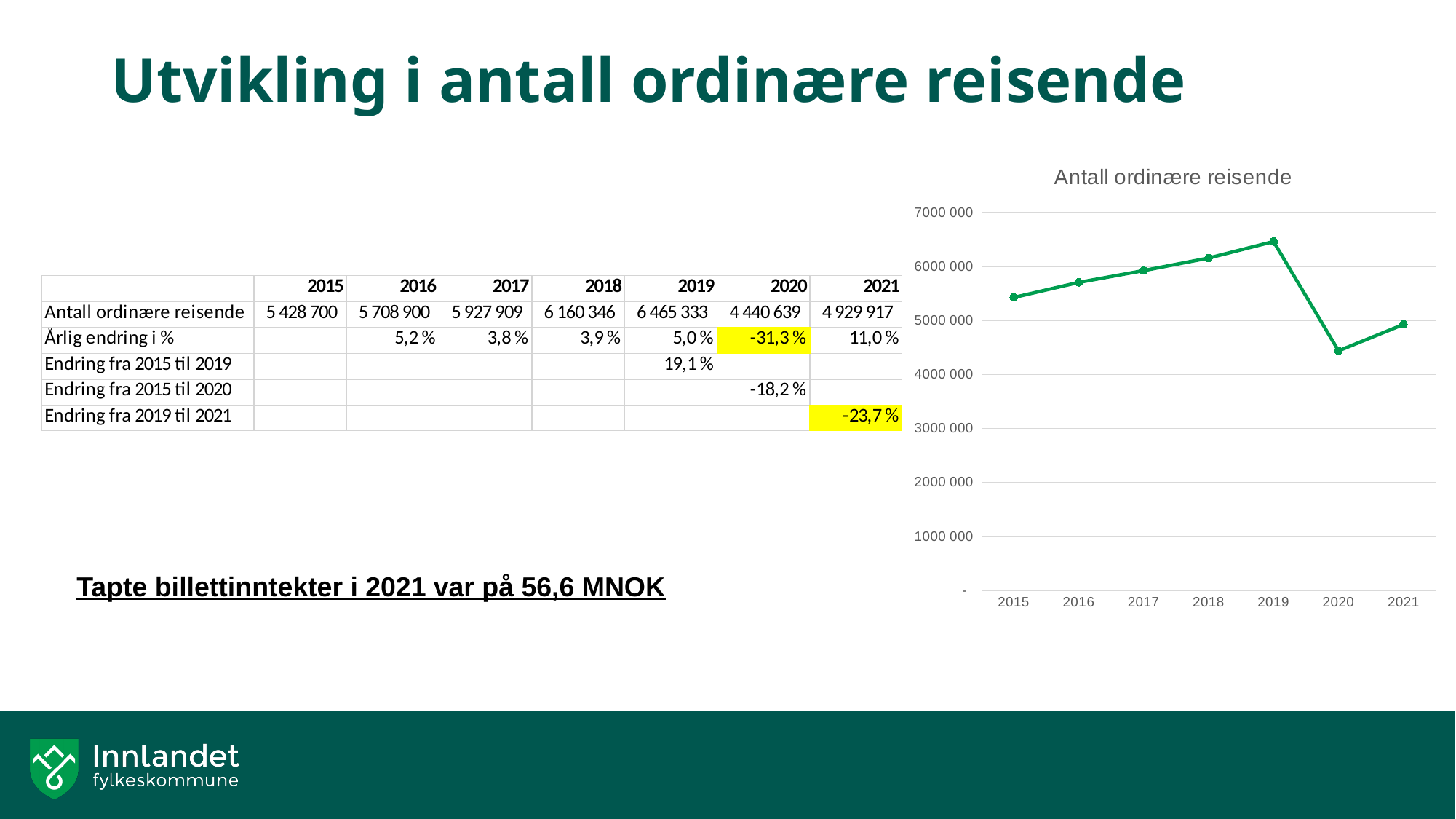
What is the title of the chart? Antall ordinære reisende How many years are plotted on the x axis of the chart? 7 Is the value for 2021 greater or less than 2019? less Do the values rise or fall from 2015 to 2019? rise What kind of chart is shown on the slide? line chart Which year has the highest number of ordinary travellers in the chart? 2019 Which year has the lowest number of ordinary travellers in the chart? 2020 What is the number of ordinary travellers in 2020? 4 440 639 What is the percentage change from 2019 to 2021 shown in the table? -23,7 % Is the value for 2020 greater or less than 5000 000? less Is the value for 2019 greater or less than 6000 000? greater What is the number of ordinary travellers in 2019? 6 465 333